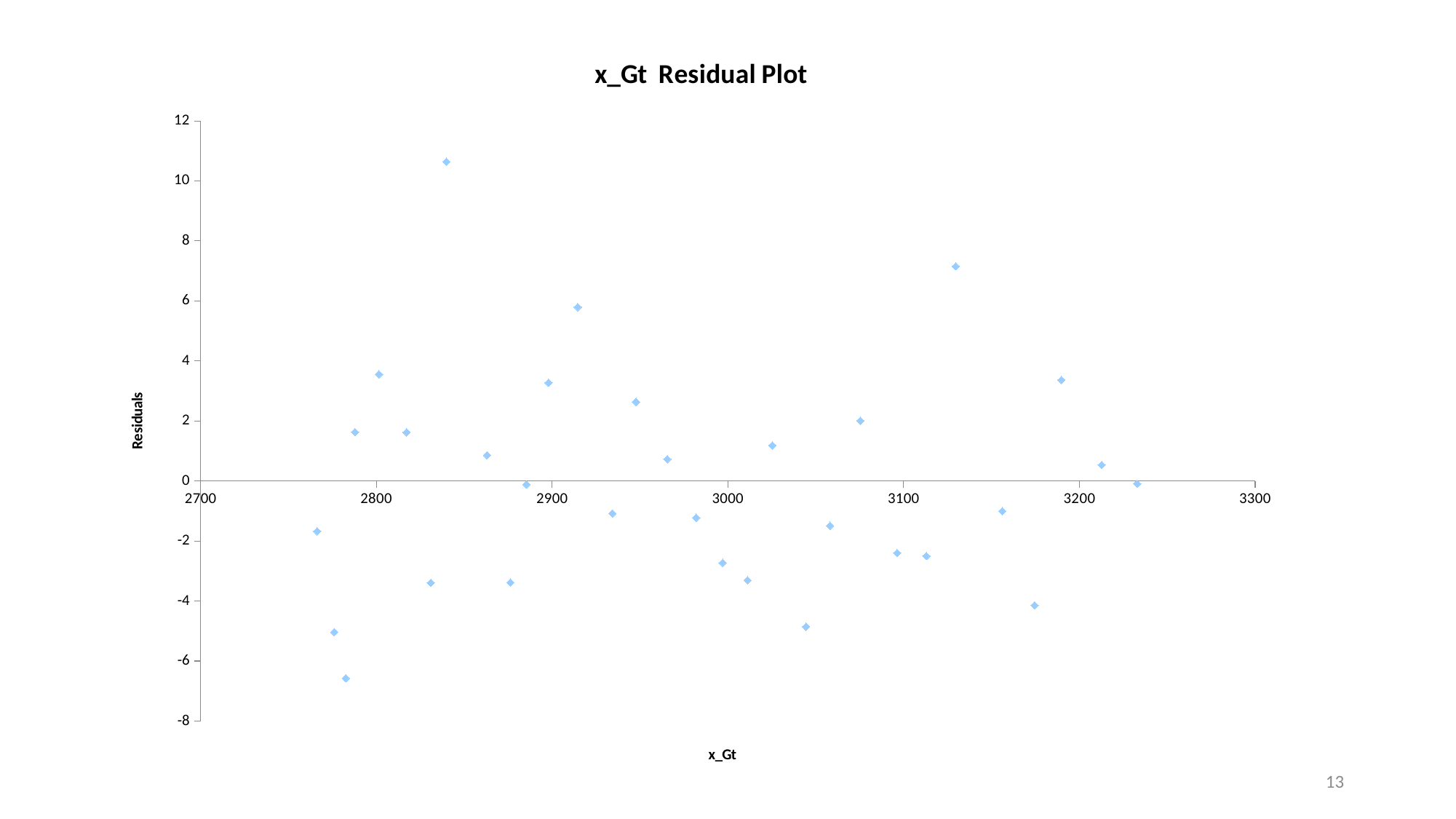
Is the residual for the point near x_Gt = 3130 greater or less than 6? greater What is the title of the chart? x_Gt Residual Plot Is the lowest residual on the chart greater or less than -6? less Is the residual for the point near x_Gt = 2914 greater or less than 4? greater What kind of chart is shown on the slide? scatter plot Which has the lower residual: the point near x_Gt = 2782 or the point near x_Gt = 3175? the point near x_Gt = 2782 What label is shown on the vertical axis of the chart? Residuals How many data points are plotted on the chart? 31 Which has the larger residual: the point near x_Gt = 2840 or the point near x_Gt = 3130? the point near x_Gt = 2840